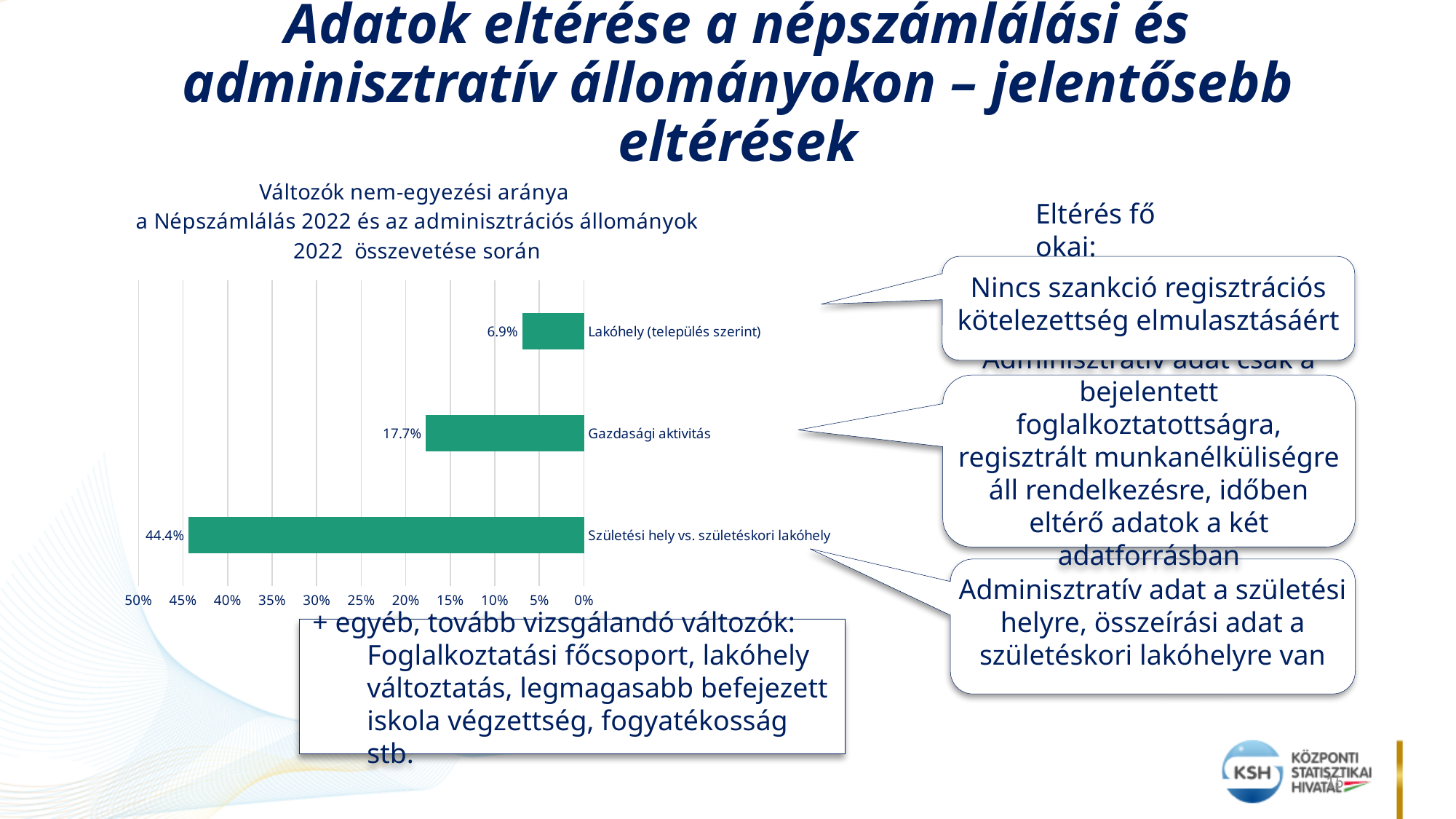
What is the value for Gazdasági aktivitás? 17.7% Which category has the highest non-match rate? Születési hely vs. születéskori lakóhely What is the maximum value shown on the chart's percentage axis? 50% How many categories are shown in the chart? 3 What is the value for Születési hely vs. születéskori lakóhely? 44.4% What is the value for Lakóhely (település szerint)? 6.9% Is the value for Gazdasági aktivitás greater or less than 20%? less Which category has the lowest non-match rate? Lakóhely (település szerint) What kind of chart is shown on the slide? Bar chart What is the difference between the values for Születési hely vs. születéskori lakóhely and Gazdasági aktivitás? 26.7% Which is larger, the value for Gazdasági aktivitás or the value for Lakóhely (település szerint)? Gazdasági aktivitás What is the difference between the values for Gazdasági aktivitás and Lakóhely (település szerint)? 10.8%